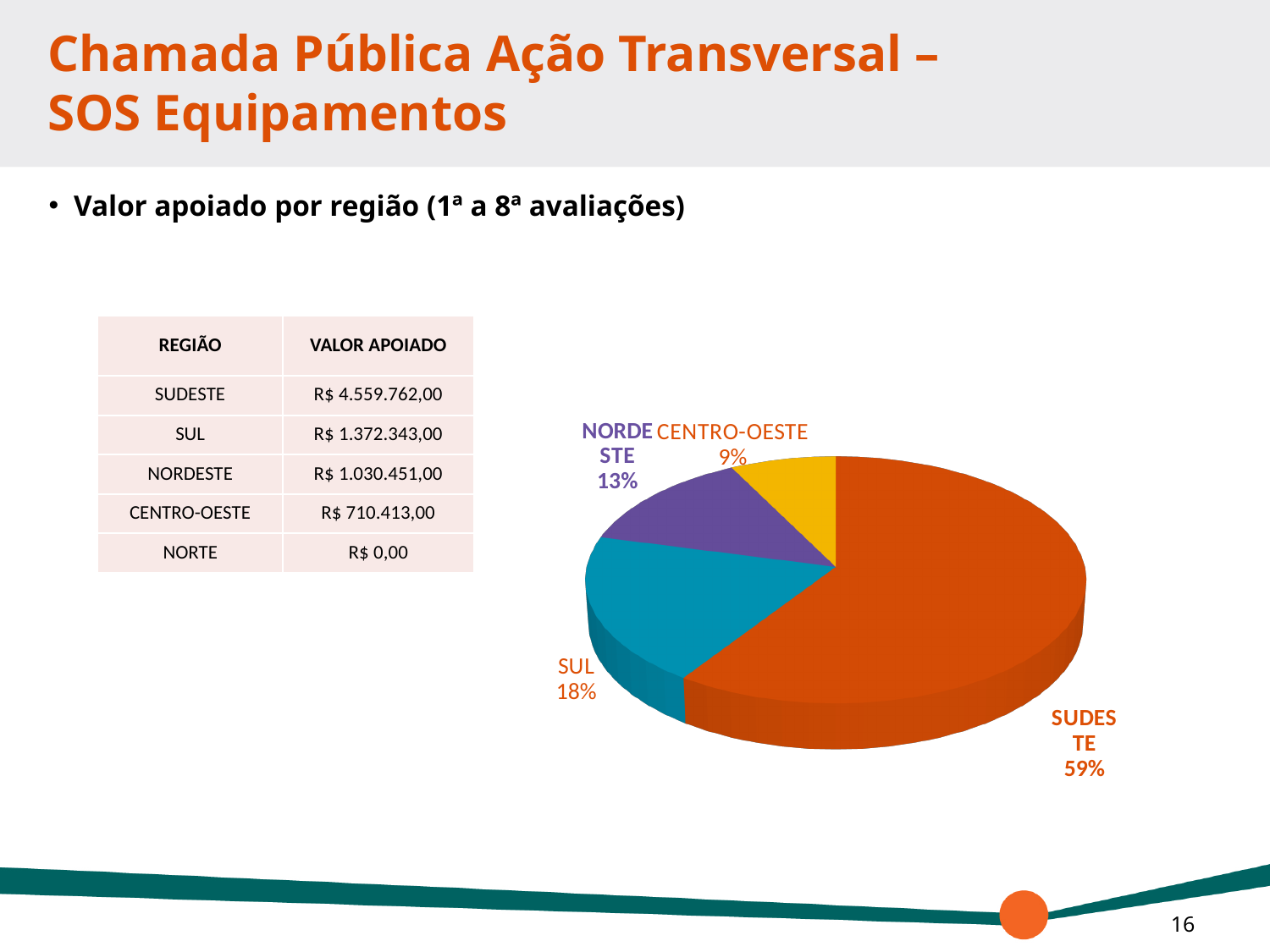
What share of the pie does SUL represent? 18% What kind of chart is shown on the slide? pie chart How many labelled slices does the pie chart have? 4 Which labelled region has the smallest slice of the pie? CENTRO-OESTE What share of the pie does CENTRO-OESTE represent? 9% Which slice is larger, SUL or NORDESTE? SUL What colour is the CENTRO-OESTE slice of the pie? yellow What is the difference in percentage points between the SUDESTE and SUL slices? 41 What share of the pie does SUDESTE represent? 59% Which region has the largest slice of the pie? SUDESTE What colour is the SUDESTE slice of the pie? orange